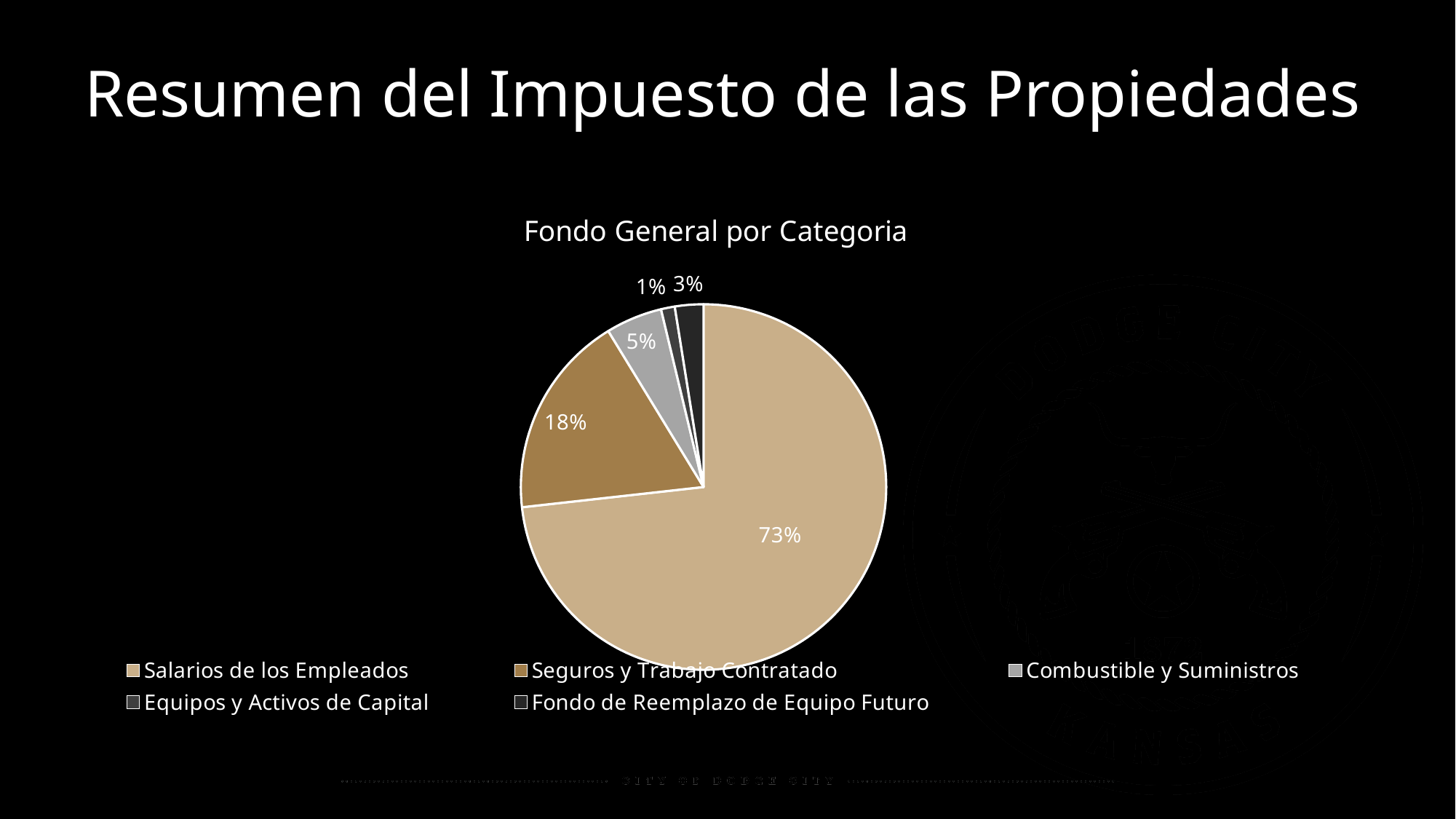
What share of the pie is Equipos y Activos de Capital? 1% What is the title of the chart? Fondo General por Categoria Which category has the largest slice of the pie? Salarios de los Empleados What is the difference in percentage points between Salarios de los Empleados and Seguros y Trabajo Contratado? 55 What share of the pie is Fondo de Reemplazo de Equipo Futuro? 3% What share of the pie is Combustible y Suministros? 5% What kind of chart is shown on the slide? pie chart How many categories does the pie chart show? 5 Which is larger, the slice for Combustible y Suministros or the slice for Fondo de Reemplazo de Equipo Futuro? Combustible y Suministros Which category has the smallest slice of the pie? Equipos y Activos de Capital